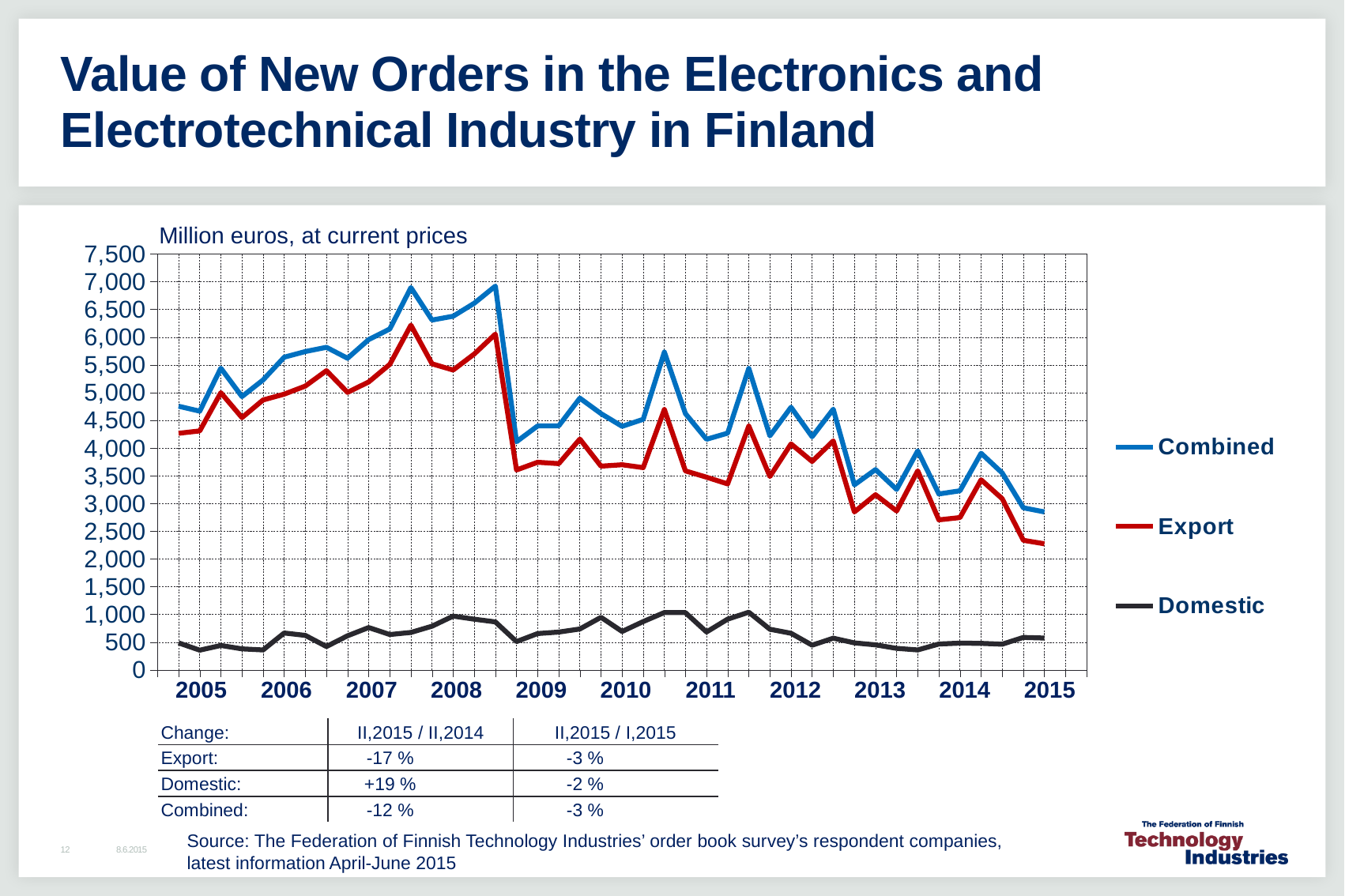
Is the value of the Export series at the end of 2015 greater or less than 2,500? less Is the Domestic series ever greater or less than 1,500 over the whole period? less What unit is stated above the chart for the values? Million euros, at current prices How many series does the legend list? 3 Which series has the highest values throughout the chart? Combined Is the value of the Combined series at the end of 2015 greater or less than 3,500? less How many year labels are shown on the x axis? 11 What kind of chart is shown on the slide? line chart Which series has the lowest values throughout the chart? Domestic Which series is larger in 2012, Export or Domestic? Export Does the Combined series rise or fall from 2008 to 2015? fall